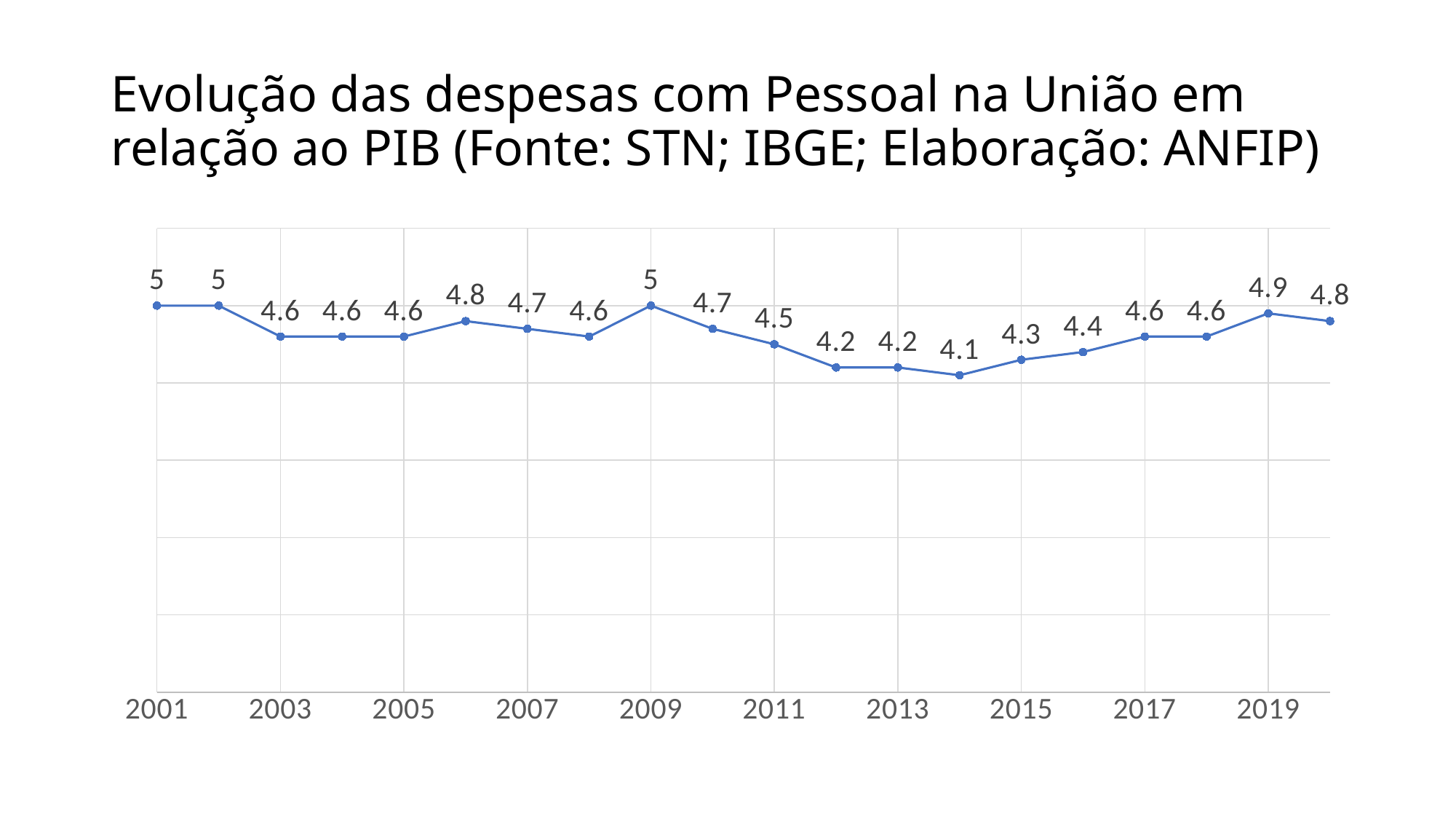
How many data points are plotted on the line? 20 What type of chart is shown on the slide? line chart Which year has the larger value, 2007 or 2015? 2007 What is the lowest value plotted on the chart? 4.1 What is the value for 2001? 5 Which sources are cited in the chart title? STN; IBGE; Elaboração: ANFIP Do the values rise or fall between 2009 and 2013? fall What is the highest value plotted on the chart? 5 What is the value for 2009? 5 What is the value for 2019? 4.9 What is the value for 2011? 4.5 What is the difference between the values for 2009 and 2013? 0.8